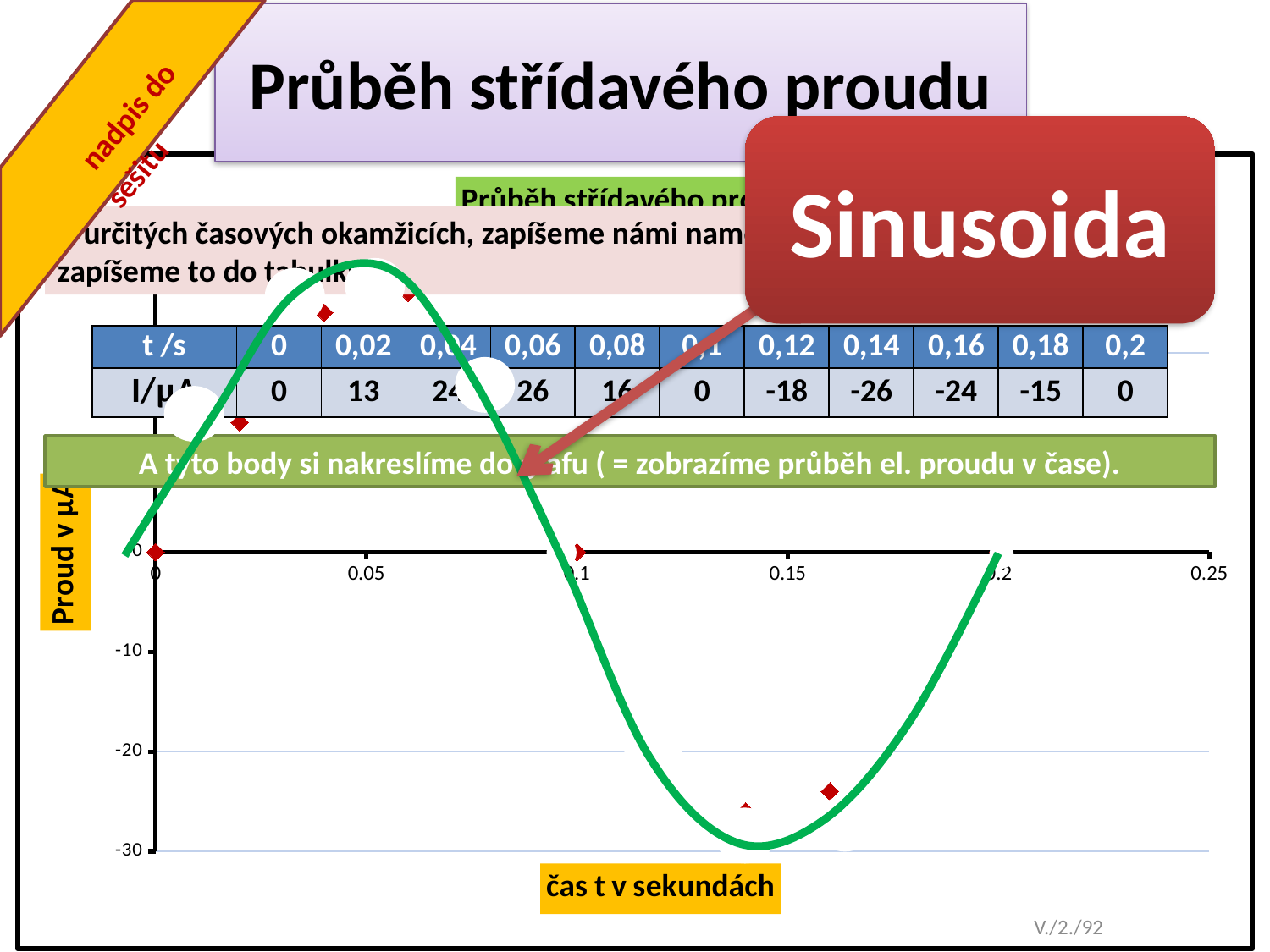
Which is larger, the current at t = 0,02 s or at t = 0,04 s? 0,04 s What is the title of the vertical axis of the chart? Proud v μA What is the difference between the highest and lowest current values in the table? 52 What kind of chart is shown on the slide? scatter chart According to the table on the slide, what is the current I at t = 0,06 s? 26 At which time t does the current reach its highest value in the table? 0,06 What is the lowest value shown on the vertical axis of the chart? -30 What is the title of the horizontal axis of the chart? čas t v sekundách How many time points are listed in the table? 11 Between t = 0.1 and t = 0.15 on the chart, does the current rise or fall? fall At which time t does the current reach its lowest value in the table? 0,14 According to the table on the slide, what is the current I at t = 0,14 s? -26